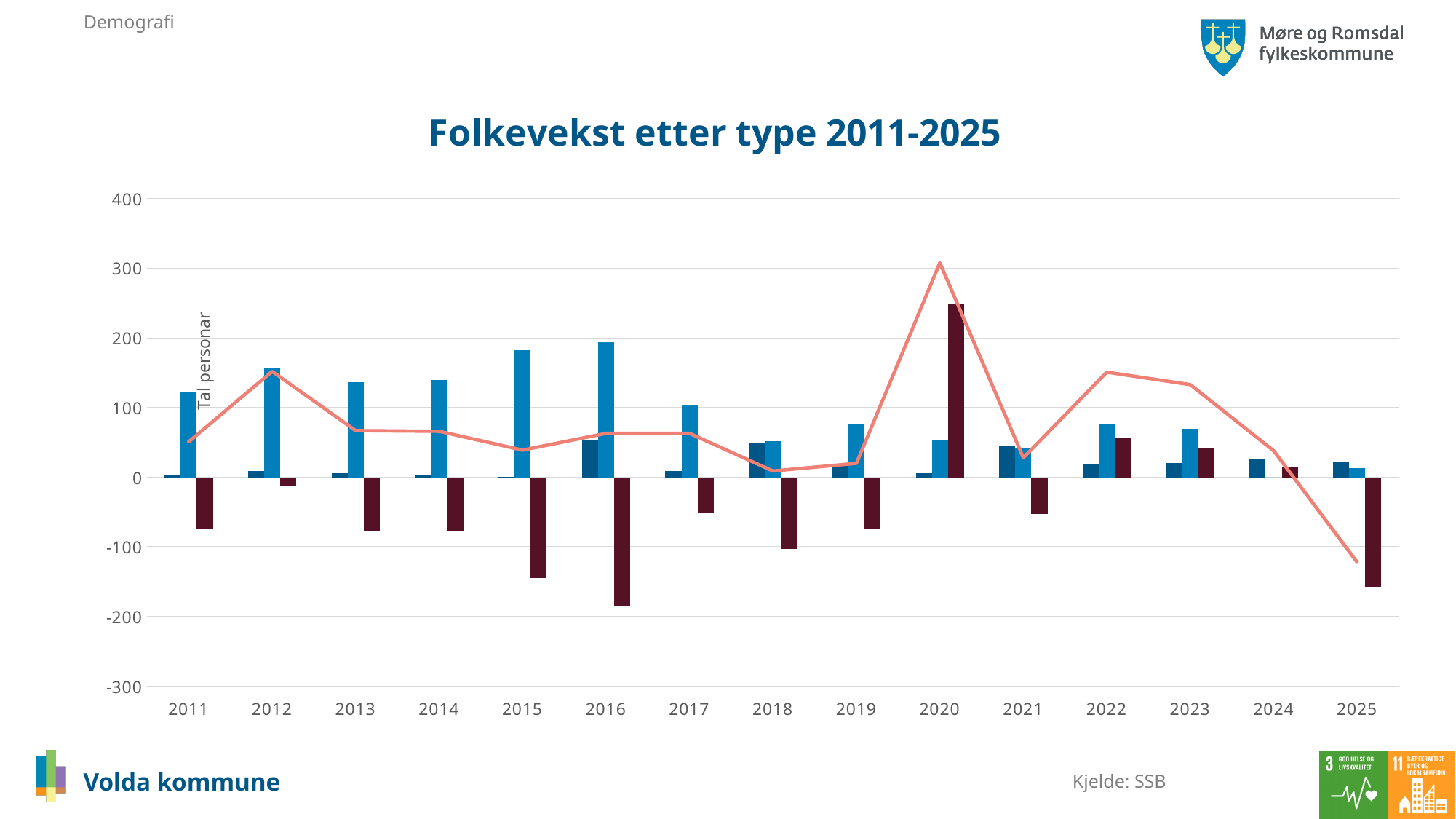
Is the value of the salmon-coloured line in 2025 greater or less than -100? less What is the label on the vertical axis of the chart? Tal personar Is the value of the dark red bar in 2016 greater or less than -100? less How many years are shown on the x axis of the chart? 15 Does the salmon-coloured line rise or fall from 2023 to 2025? fall What is the title of the chart? Folkevekst etter type 2011-2025 In which year is the dark red bar highest? 2020 What type of chart is shown on the slide? Combined bar and line chart In which year does the salmon-coloured line reach its lowest value? 2025 Is the value of the dark red bar in 2020 greater or less than 200? greater In which year does the salmon-coloured line reach its highest value? 2020